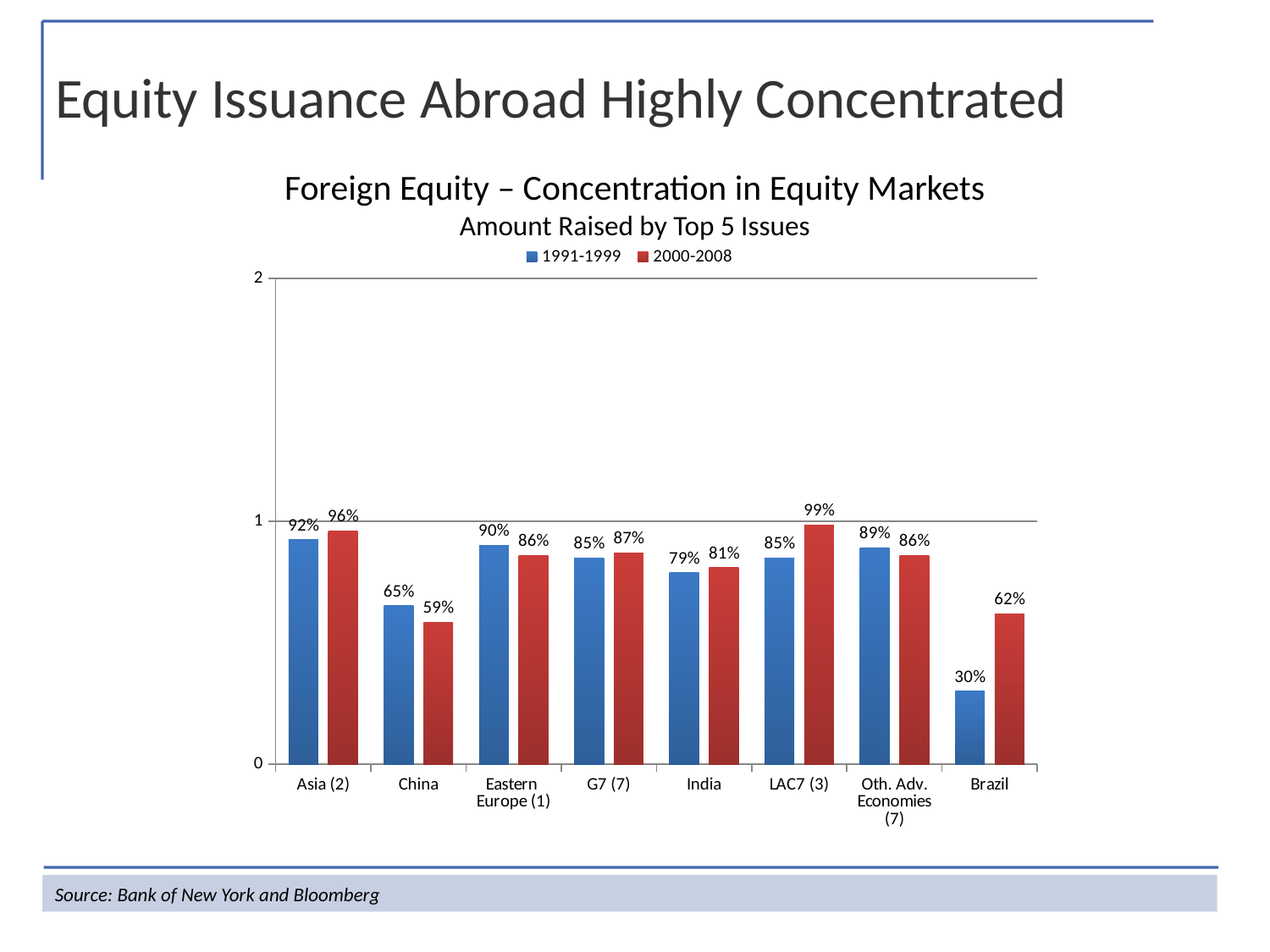
What is the difference between the 1991-1999 and 2000-2008 values for China? 6% What is the value for Brazil in the 1991-1999 series? 30% What is the value for China in the 2000-2008 series? 59% Which is larger for India: the 1991-1999 value or the 2000-2008 value? 2000-2008 Which category has the lowest value in the 1991-1999 series? Brazil How many series does the legend list? 2 What is the difference between the 2000-2008 and 1991-1999 values for Brazil? 32% Which category has the highest value in the 2000-2008 series? LAC7 (3) What is the value for LAC7 (3) in the 2000-2008 series? 99% What is the subtitle of the chart below 'Foreign Equity – Concentration in Equity Markets'? Amount Raised by Top 5 Issues How many categories are shown on the x axis? 8 What kind of chart is shown on the slide? Bar chart